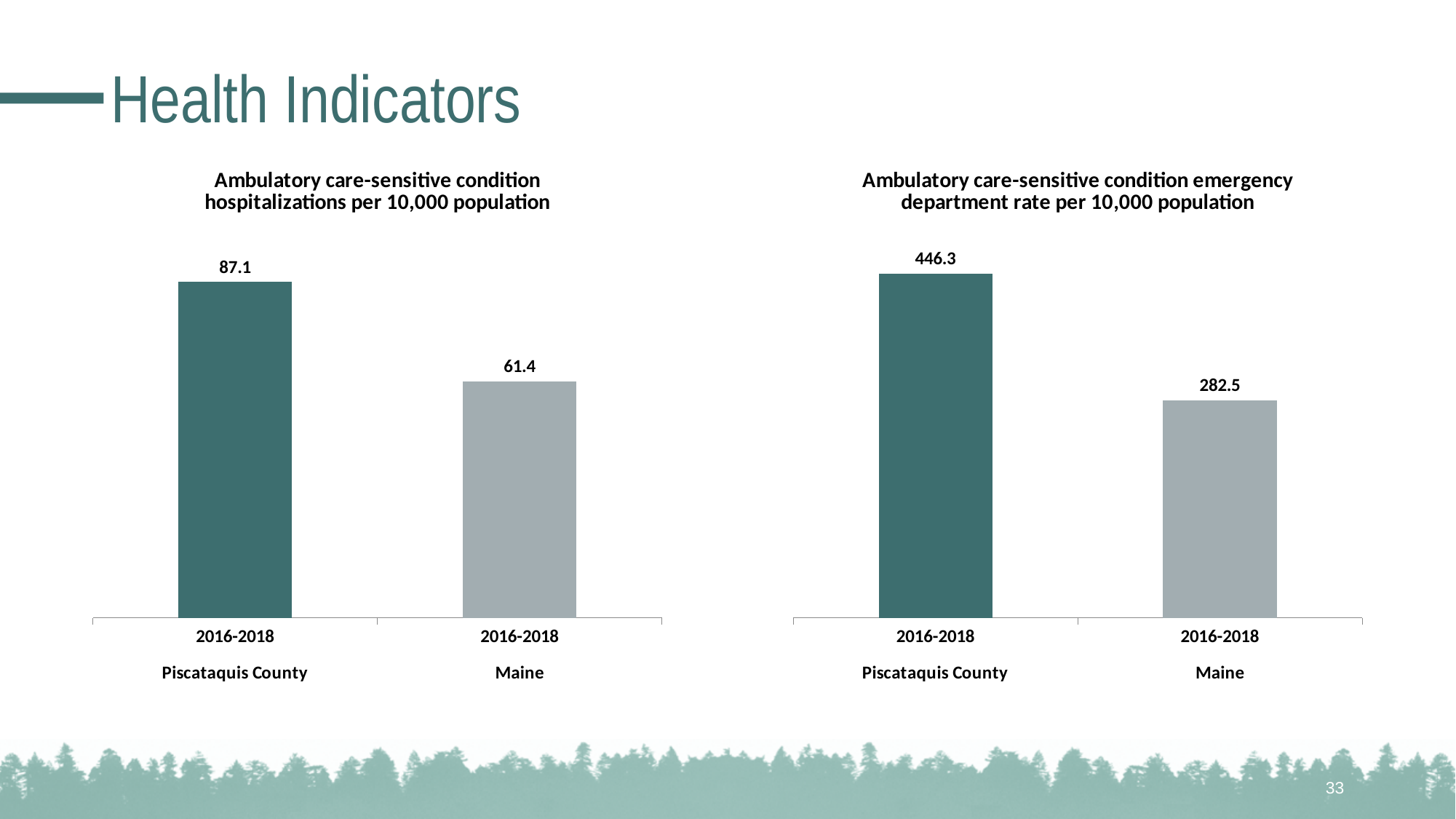
In the right chart (emergency department rate per 10,000 population), what is the difference between the Piscataquis County value and the Maine value? 163.8 In the right chart (Ambulatory care-sensitive condition emergency department rate per 10,000 population), what is the value for Piscataquis County? 446.3 In the right chart (emergency department rate per 10,000 population), is the value for Piscataquis County larger or smaller than the value for Maine? larger In the right chart (emergency department rate per 10,000 population), which category has the lower value? Maine What type of chart is the right chart (emergency department rate per 10,000 population)? bar chart In the left chart (Ambulatory care-sensitive condition hospitalizations per 10,000 population), what is the value for Maine? 61.4 What time period is shown on the x axis labels of both charts? 2016-2018 In the left chart (Ambulatory care-sensitive condition hospitalizations per 10,000 population), what is the value for Piscataquis County? 87.1 How many bars are plotted in the left chart (hospitalizations per 10,000 population)? 2 In the right chart (Ambulatory care-sensitive condition emergency department rate per 10,000 population), what is the value for Maine? 282.5 In the left chart (hospitalizations per 10,000 population), which category has the higher value? Piscataquis County In the left chart (hospitalizations per 10,000 population), what is the difference between the Piscataquis County value and the Maine value? 25.7